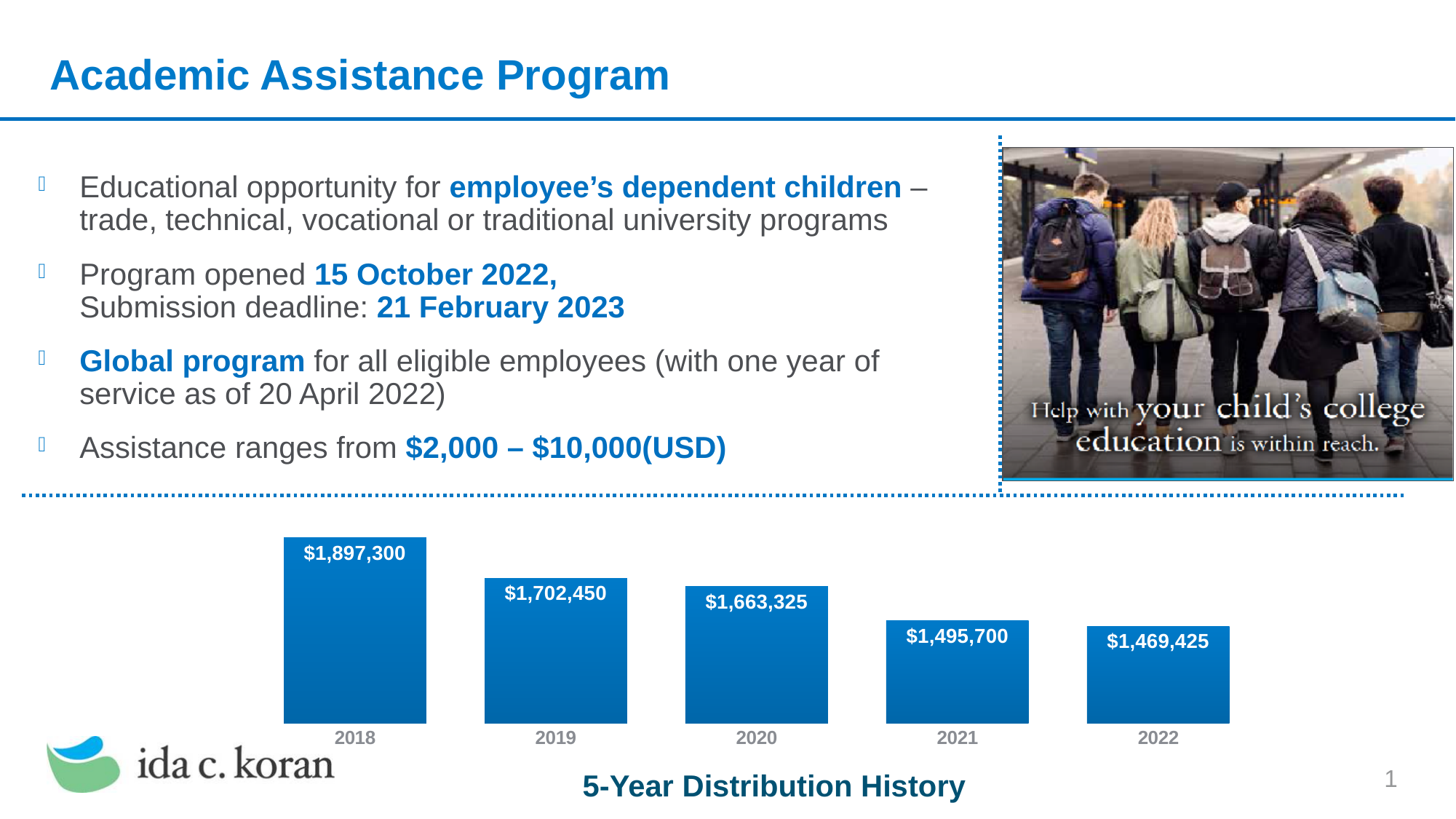
What was the distribution amount in 2022? $1,469,425 Do the distribution amounts rise or fall from 2018 to 2022? Fall What kind of chart is shown on the slide? Bar chart Which year had the highest distribution amount? 2018 Which year had a larger distribution amount, 2019 or 2020? 2019 How many years are shown in the chart? 5 Which year had the lowest distribution amount? 2022 What was the distribution amount in 2020? $1,663,325 What was the distribution amount in 2021? $1,495,700 What is the difference between the 2021 and 2022 distribution amounts? $26,275 What was the distribution amount in 2018? $1,897,300 What is the difference between the 2018 and 2019 distribution amounts? $194,850